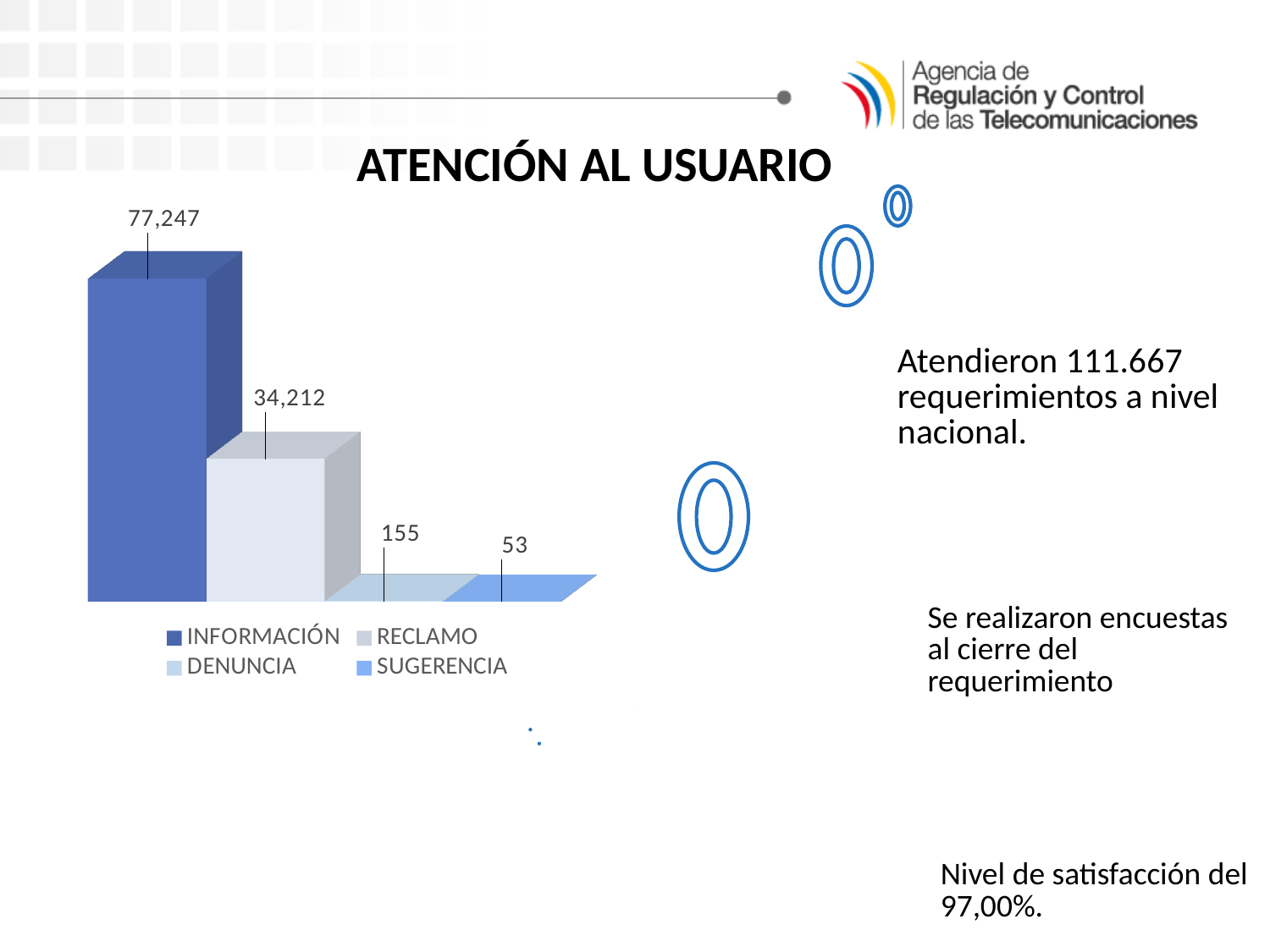
Which is larger, the value for RECLAMO or the value for DENUNCIA? RECLAMO How many entries does the chart legend list? 4 What is the value for INFORMACIÓN? 77,247 Which category has the lowest value? SUGERENCIA Which category has the highest value? INFORMACIÓN What is the value for SUGERENCIA? 53 What is the value for RECLAMO? 34,212 What is the value for DENUNCIA? 155 What kind of chart is shown on the slide? Bar chart What is the difference between the values for DENUNCIA and SUGERENCIA? 102 How many categories are shown in the chart? 4 What is the difference between the values for INFORMACIÓN and RECLAMO? 43,035